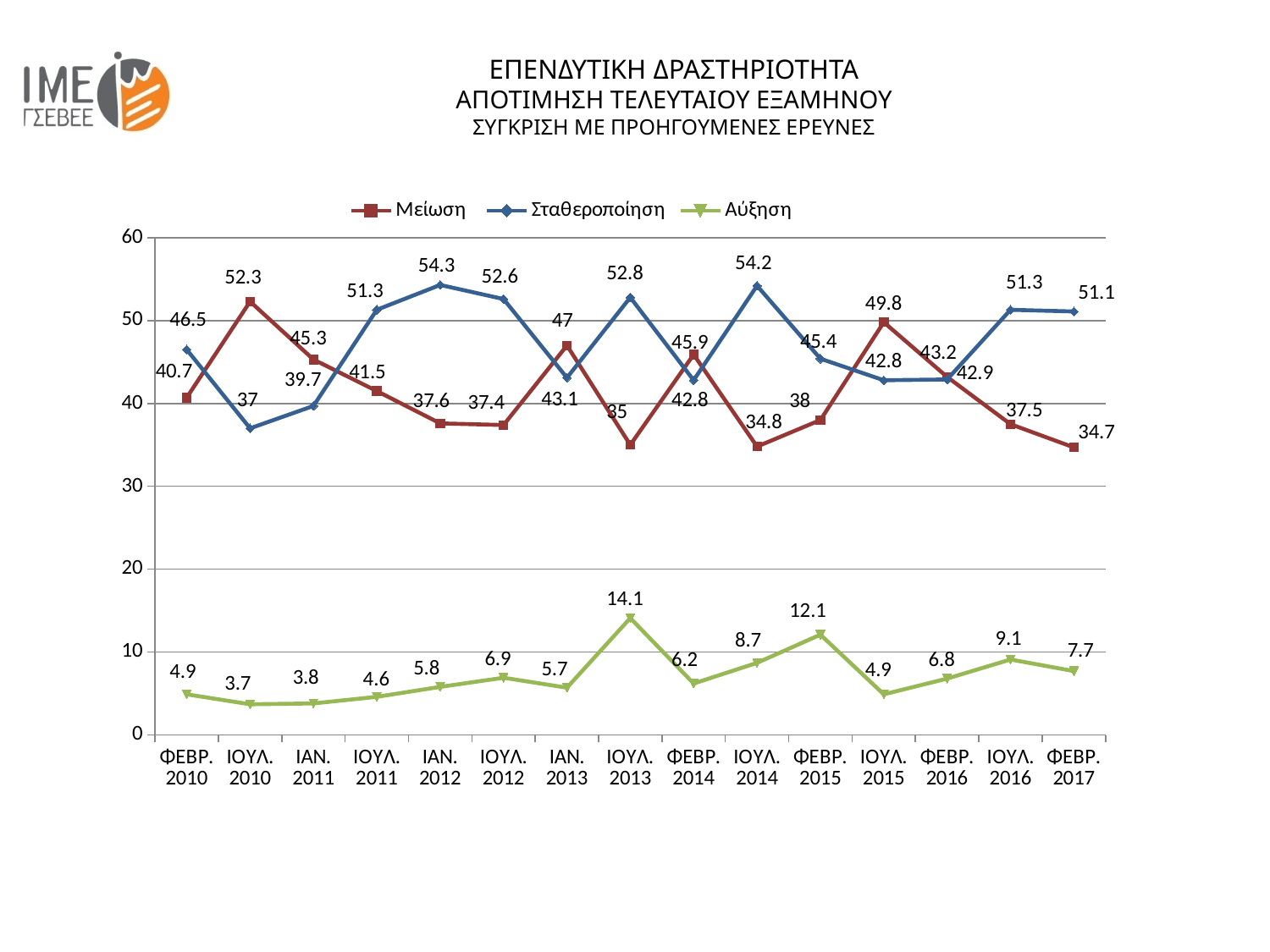
What is the value of Μείωση for ΦΕΒΡ. 2017? 34.7 How many time points are plotted along the x axis? 15 What is the value of Σταθεροποίηση for ΙΑΝ. 2012? 54.3 At which time point is Μείωση highest? ΙΟΥΛ. 2010 At which time point is Αύξηση highest? ΙΟΥΛ. 2013 Which series is drawn in green? Αύξηση At which time point is Αύξηση lowest? ΙΟΥΛ. 2010 How many series does the legend list? 3 What is the value of Αύξηση for ΙΟΥΛ. 2013? 14.1 What type of chart is shown on the slide? line chart What is the difference between Σταθεροποίηση and Μείωση in ΦΕΒΡ. 2017? 16.4 In ΙΟΥΛ. 2015, which is larger: Μείωση or Σταθεροποίηση? Μείωση